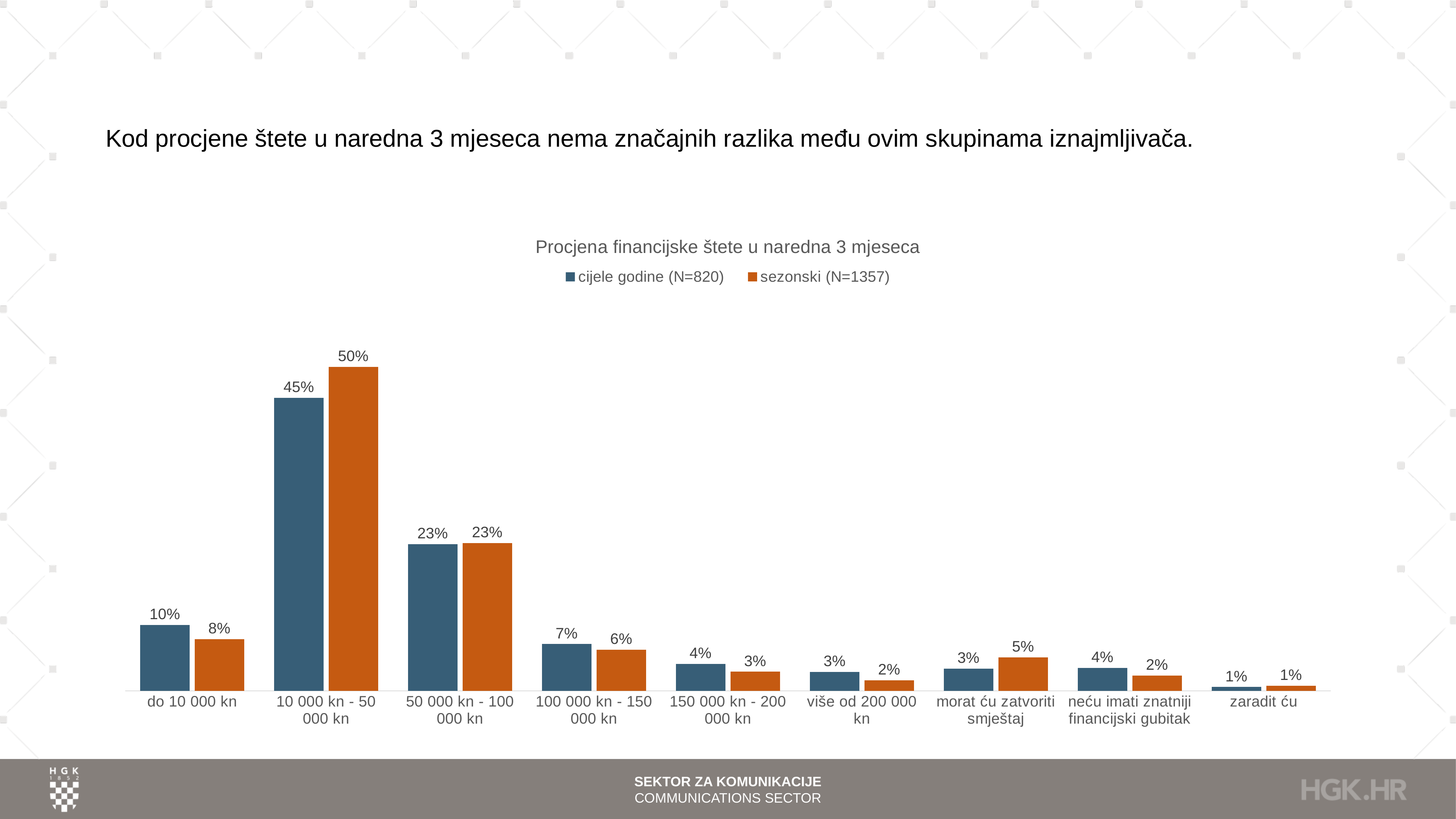
What kind of chart is shown on the slide? bar chart What is the difference between the 'sezonski (N=1357)' and 'cijele godine (N=820)' values in the '10 000 kn - 50 000 kn' category? 5% What is the value for 'sezonski (N=1357)' in the 'morat ću zatvoriti smještaj' category? 5% What is the value for 'cijele godine (N=820)' in the '10 000 kn - 50 000 kn' category? 45% Which category has the lowest value for the 'cijele godine (N=820)' series? zaradit ću Which category has the highest value for the 'sezonski (N=1357)' series? 10 000 kn - 50 000 kn How many series does the legend list? 2 What is the title of the chart? Procjena financijske štete u naredna 3 mjeseca How many categories are shown on the x axis? 9 In the 'do 10 000 kn' category, which series has the larger value? cijele godine (N=820) What colour are the bars for the 'sezonski (N=1357)' series? orange What is the value for 'sezonski (N=1357)' in the 'do 10 000 kn' category? 8%